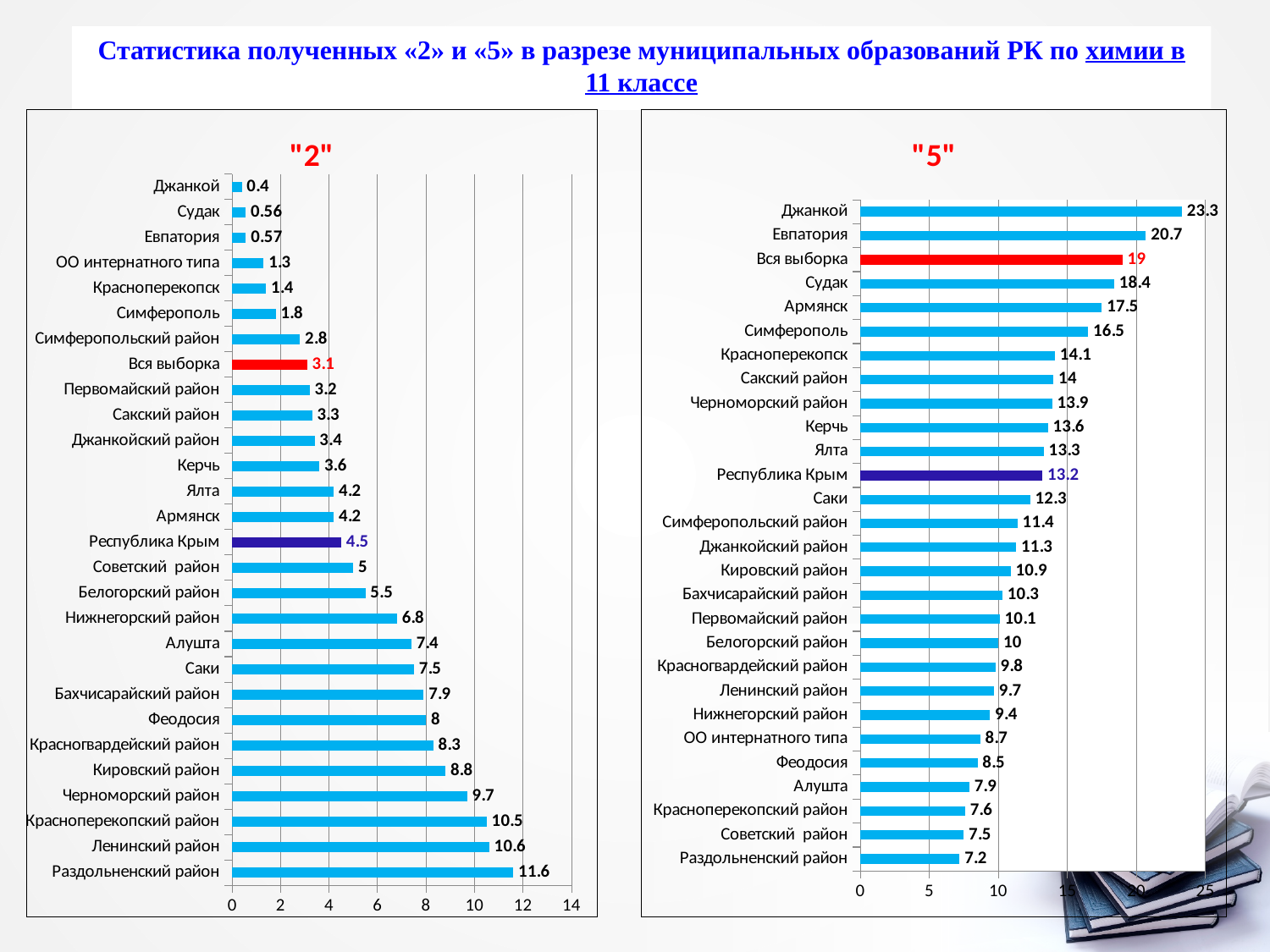
In the "5" chart, what is the value for Джанкой? 23.3 In the "5" chart, which category has the highest value? Джанкой In the "2" chart, which category has the lowest value? Джанкой In the "2" chart, what is the value for Раздольненский район? 11.6 What type of chart is the "2" chart? bar chart In the "2" chart, is the value for Черноморский район greater or less than 8? greater In the "5" chart, what colour is the bar for Вся выборка? red How many categories are shown in the "5" chart? 28 In the "5" chart, which is larger, Евпатория or Судак? Евпатория In the "5" chart, what is the difference between Вся выборка and Республика Крым? 5.8 In the "5" chart, which category has the lowest value? Раздольненский район In the "2" chart, what is the difference between Республика Крым and Вся выборка? 1.4